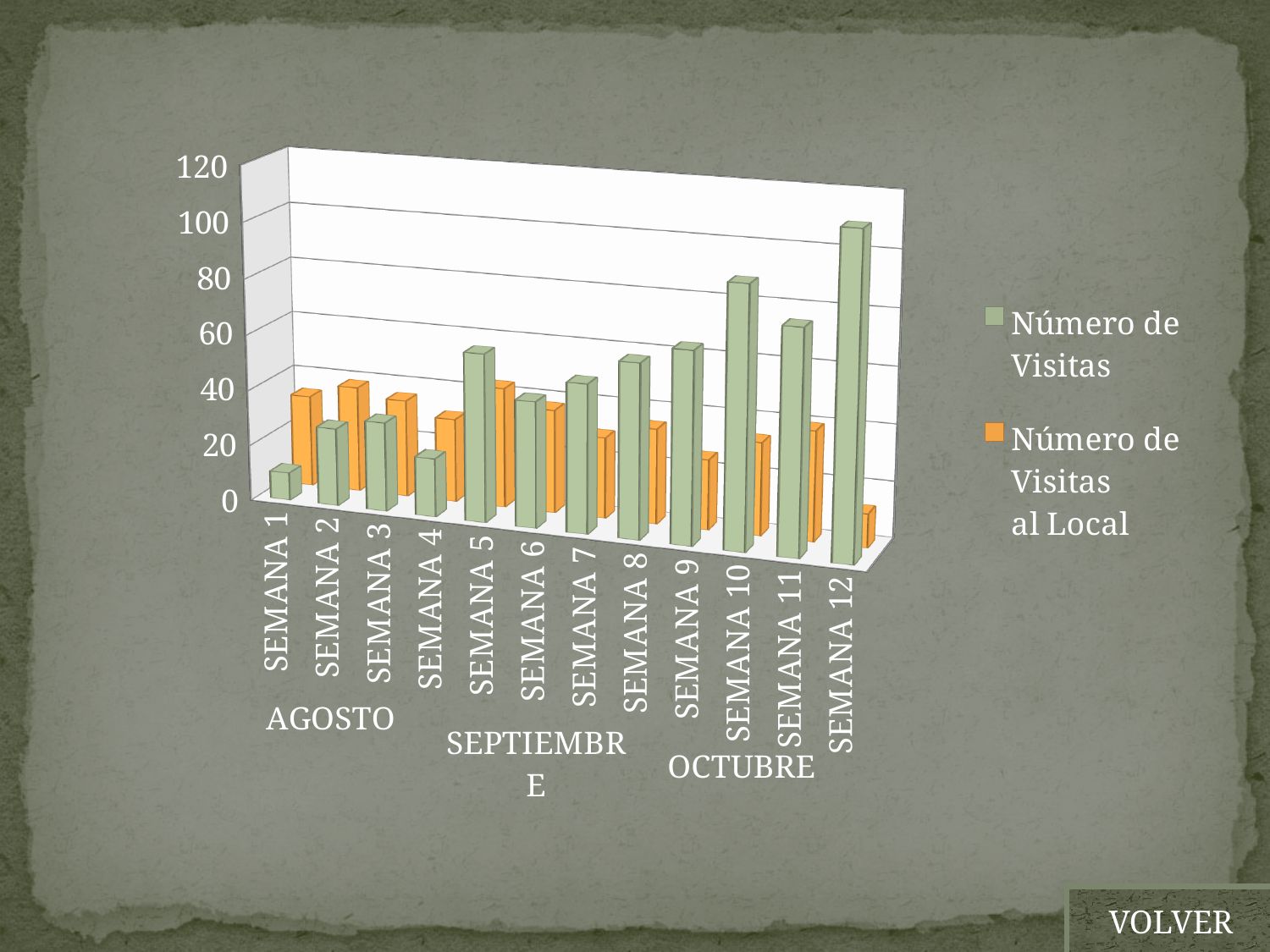
Which month groups are labelled along the x axis? AGOSTO, SEPTIEMBRE, OCTUBRE How many weeks (categories) are plotted on the x axis? 12 Is the value of Número de Visitas al Local for SEMANA 12 greater or less than 20? less For SEMANA 1, which series has the larger value: Número de Visitas or Número de Visitas al Local? Número de Visitas al Local Which week has the highest value for Número de Visitas? SEMANA 12 Is the value of Número de Visitas for SEMANA 1 greater or less than 20? less How many series does the legend list? 2 What kind of chart is shown on the slide? bar chart For SEMANA 12, which series has the larger value: Número de Visitas or Número de Visitas al Local? Número de Visitas Is the value of Número de Visitas for SEMANA 10 greater or less than 60? greater Which week has the lowest value for Número de Visitas? SEMANA 1